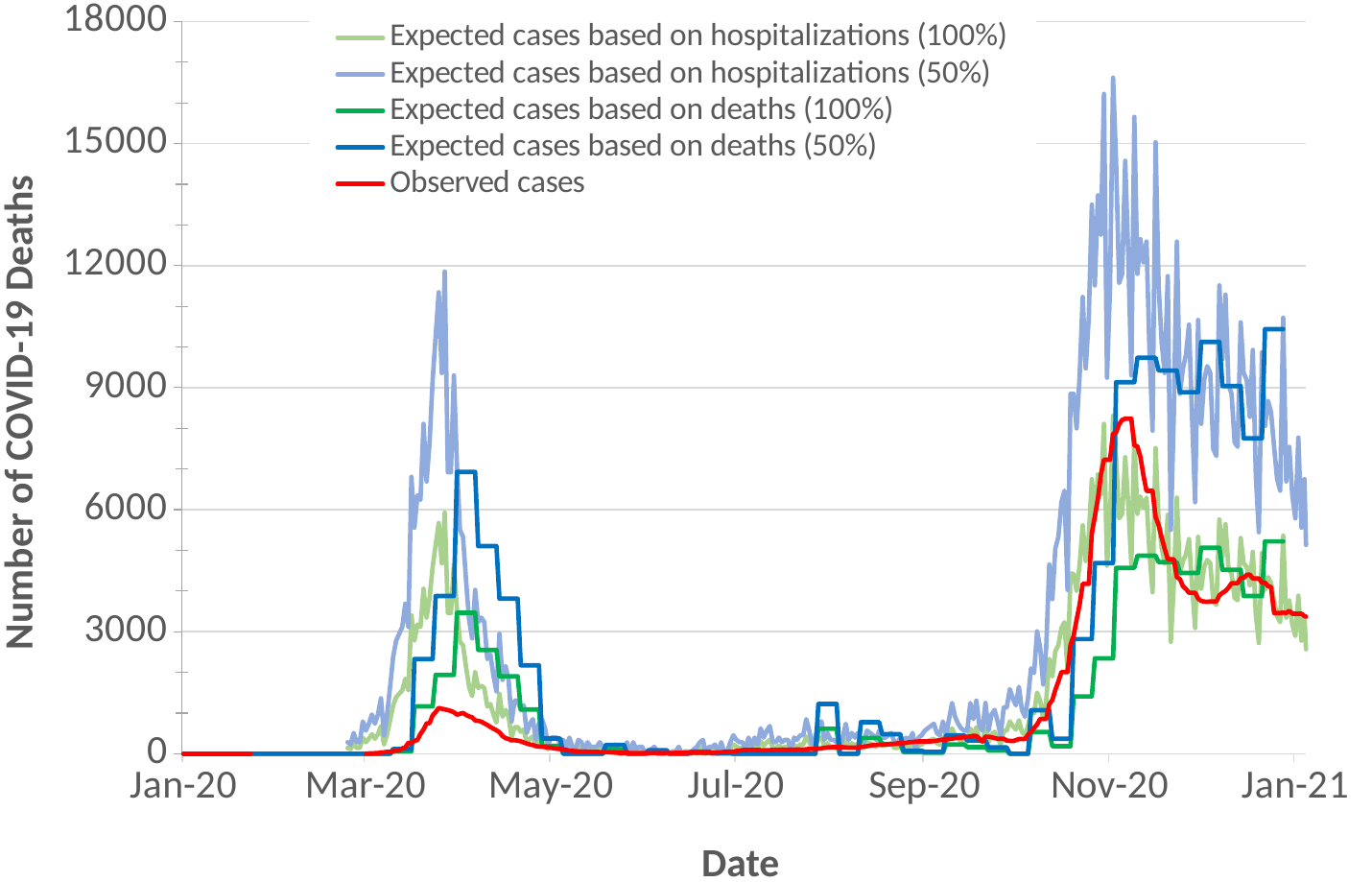
Around Nov-20, which series reaches a higher value: Expected cases based on hospitalizations (50%) or Observed cases? Expected cases based on hospitalizations (50%) During the spring 2020 peak (around Mar-20 to May-20), which series reaches a higher value: Expected cases based on deaths (50%) or Observed cases? Expected cases based on deaths (50%) Do Observed cases rise or fall between Sep-20 and Nov-20? rise What is the highest value shown on the y axis? 18000 Is the peak value of Observed cases around Nov-20 greater or less than 9000? less What is the label of the y axis? Number of COVID-19 Deaths Is the peak value of Observed cases around Nov-20 greater or less than 6000? greater How many series does the legend list? 5 What kind of chart is shown on the slide? line chart Is the highest value of Expected cases based on hospitalizations (50%) greater or less than 15000? greater Which series is drawn in red? Observed cases